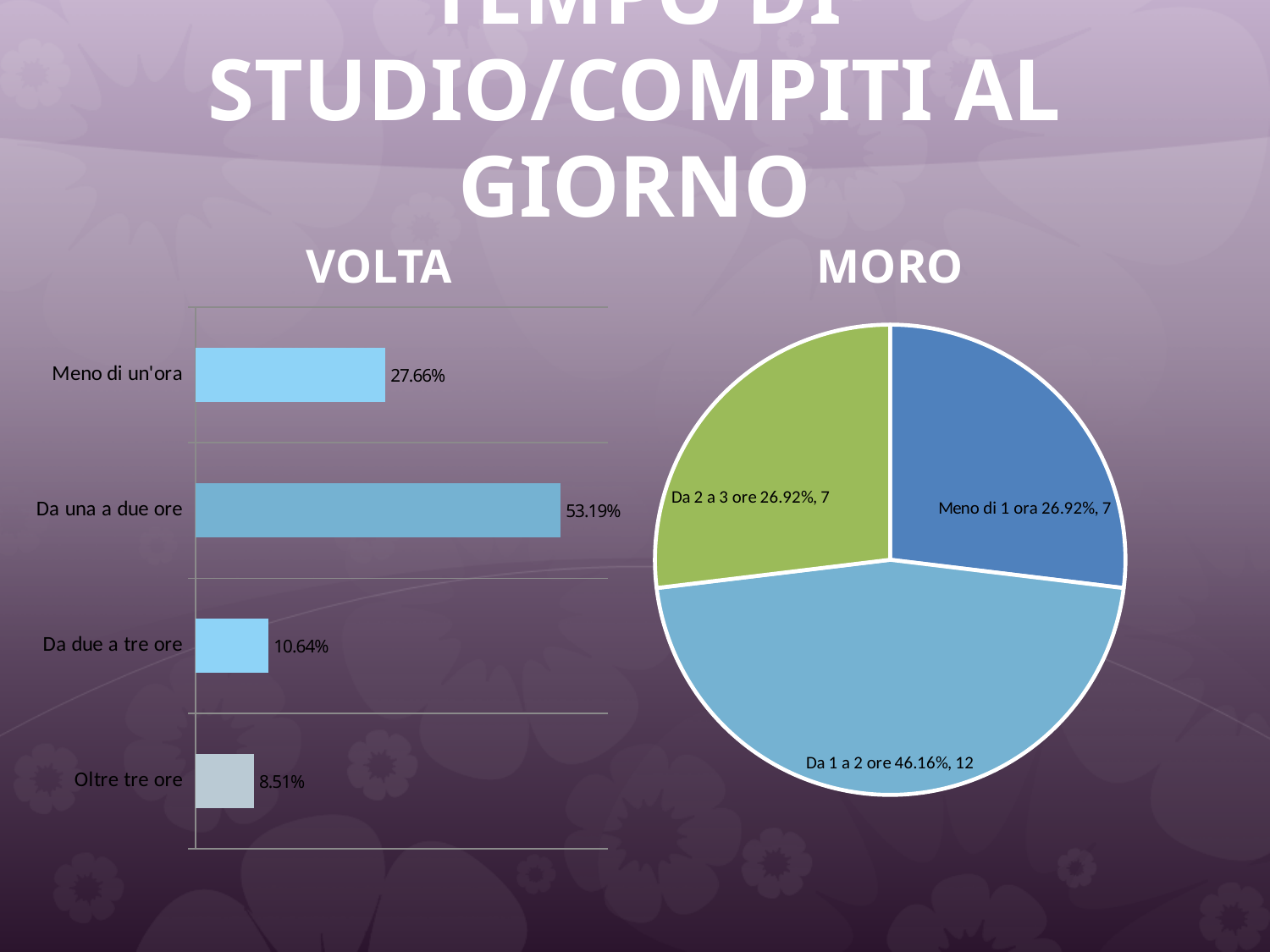
In the VOLTA chart, which category has the lowest value? Oltre tre ore In the VOLTA chart, what is the difference between "Meno di un'ora" and "Da due a tre ore"? 17.02% In the VOLTA chart, which category has the highest value? Da una a due ore How many categories does the VOLTA chart show? 4 In the MORO chart, which category has the largest slice? Da 1 a 2 ore What kind of chart is the VOLTA chart? Bar chart In the VOLTA chart, what is the value for "Oltre tre ore"? 8.51% In the VOLTA chart, what is the value for "Da una a due ore"? 53.19% In the MORO chart, what is the count for "Da 1 a 2 ore"? 12 In the MORO chart, what share of the pie does "Da 2 a 3 ore" represent? 26.92% In the VOLTA chart, which is larger: "Meno di un'ora" or "Da due a tre ore"? Meno di un'ora What kind of chart is the MORO chart? Pie chart